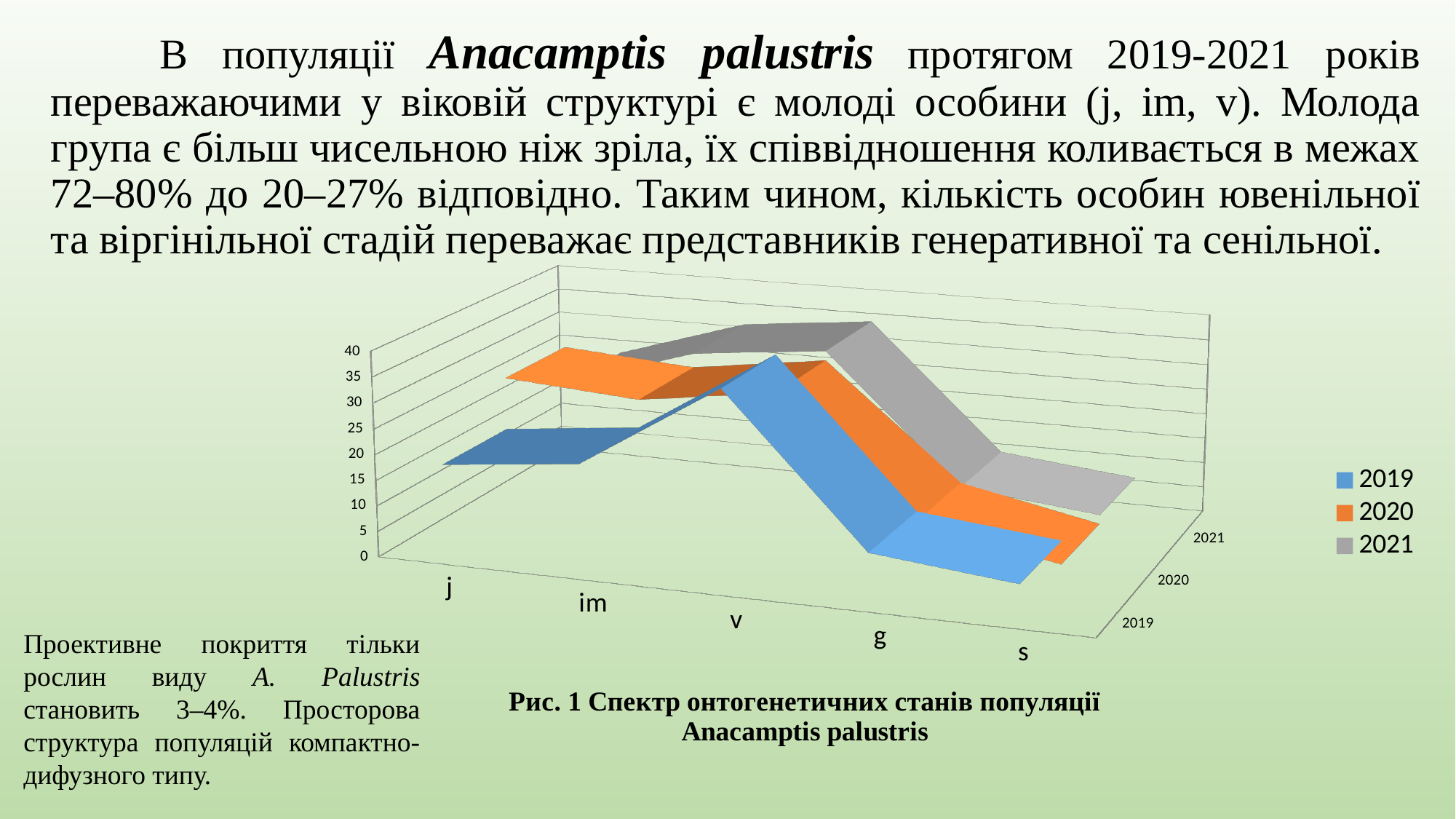
How many ontogenetic state categories are shown along the x axis of the chart? 5 Is the 2019 value for category j greater or less than 30? less For the 2021 series, do the values rise or fall from category v to category g? fall What is the highest value shown on the vertical axis of the chart? 40 Which years are listed in the chart legend? 2019, 2020, 2021 For the 2019 series, which is larger: the value for j or the value for v? v For the 2021 series, which category has the highest value? v What are the category labels along the x axis of the chart? j, im, v, g, s For the 2019 series, which category has the highest value? v How many series does the chart legend list? 3 Is the 2019 value for category v greater or less than 30? greater